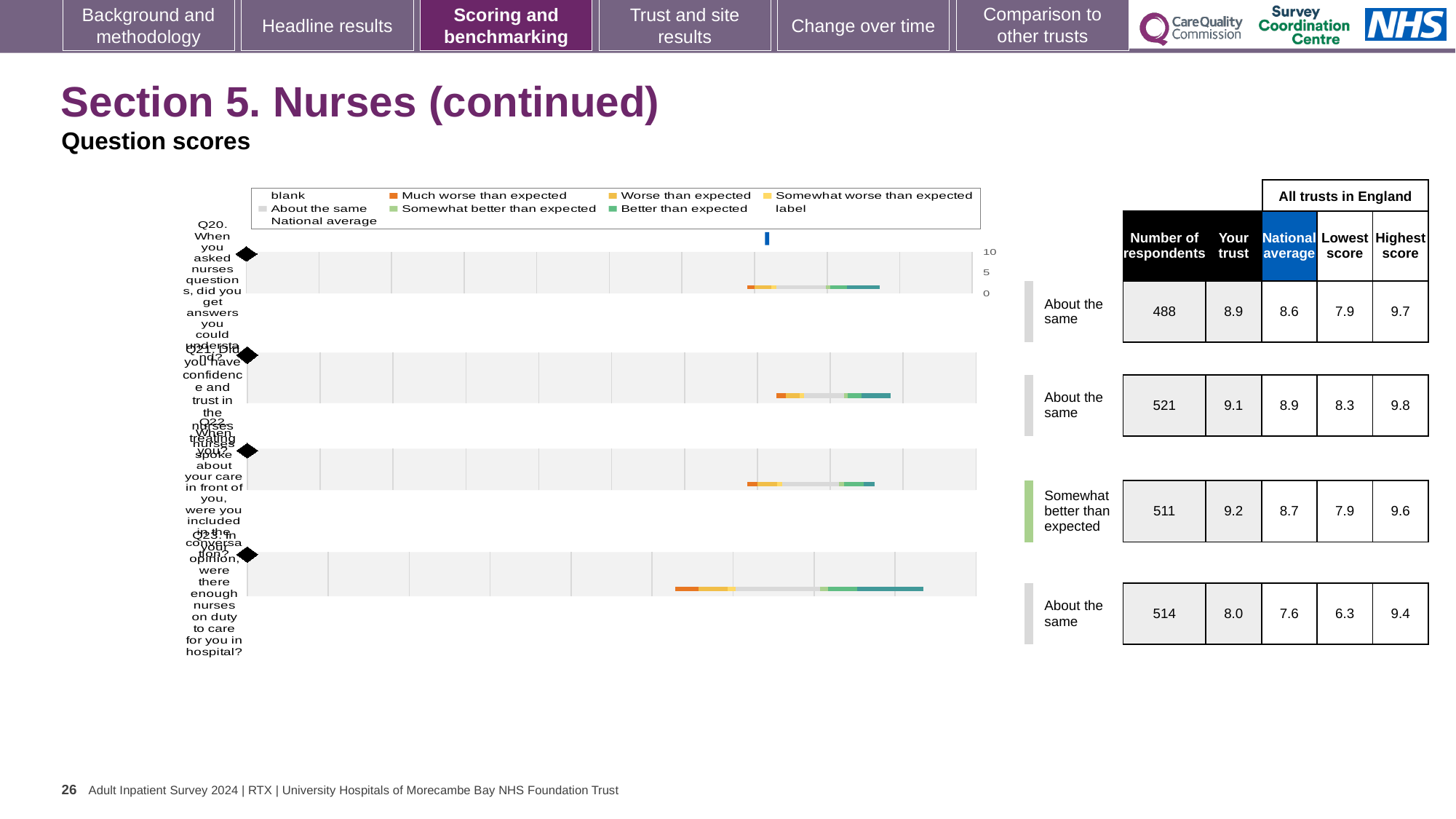
For Q21 (Did you have confidence and trust in the nurses treating you?), what is the 'Your trust' score? 9.1 Which question (Q20 to Q23) has the highest 'Your trust' score? Q22 What kind of chart is used to show the question scores for Q20 to Q23? bar chart What benchmark category is shown for Q22 (When nurses spoke about your care in front of you, were you included in the conversation?)? Somewhat better than expected For Q23, what is the difference between the highest score (9.4) and the lowest score (6.3) among all trusts in England? 3.1 For Q23 (In your opinion, were there enough nurses on duty to care for you in hospital?), what is the lowest score among all trusts in England? 6.3 For Q20, which is larger: the 'Your trust' score or the national average? Your trust For Q20 (When you asked nurses questions, did you get answers you could understand?), how many respondents are listed? 488 How many question charts (Q20 to Q23) are shown on the slide? 4 For Q22 (When nurses spoke about your care in front of you, were you included in the conversation?), what is the national average score? 8.7 Which question (Q20 to Q23) has the lowest 'Your trust' score? Q23 What is the maximum value shown on the score axis of the Q20 chart? 10